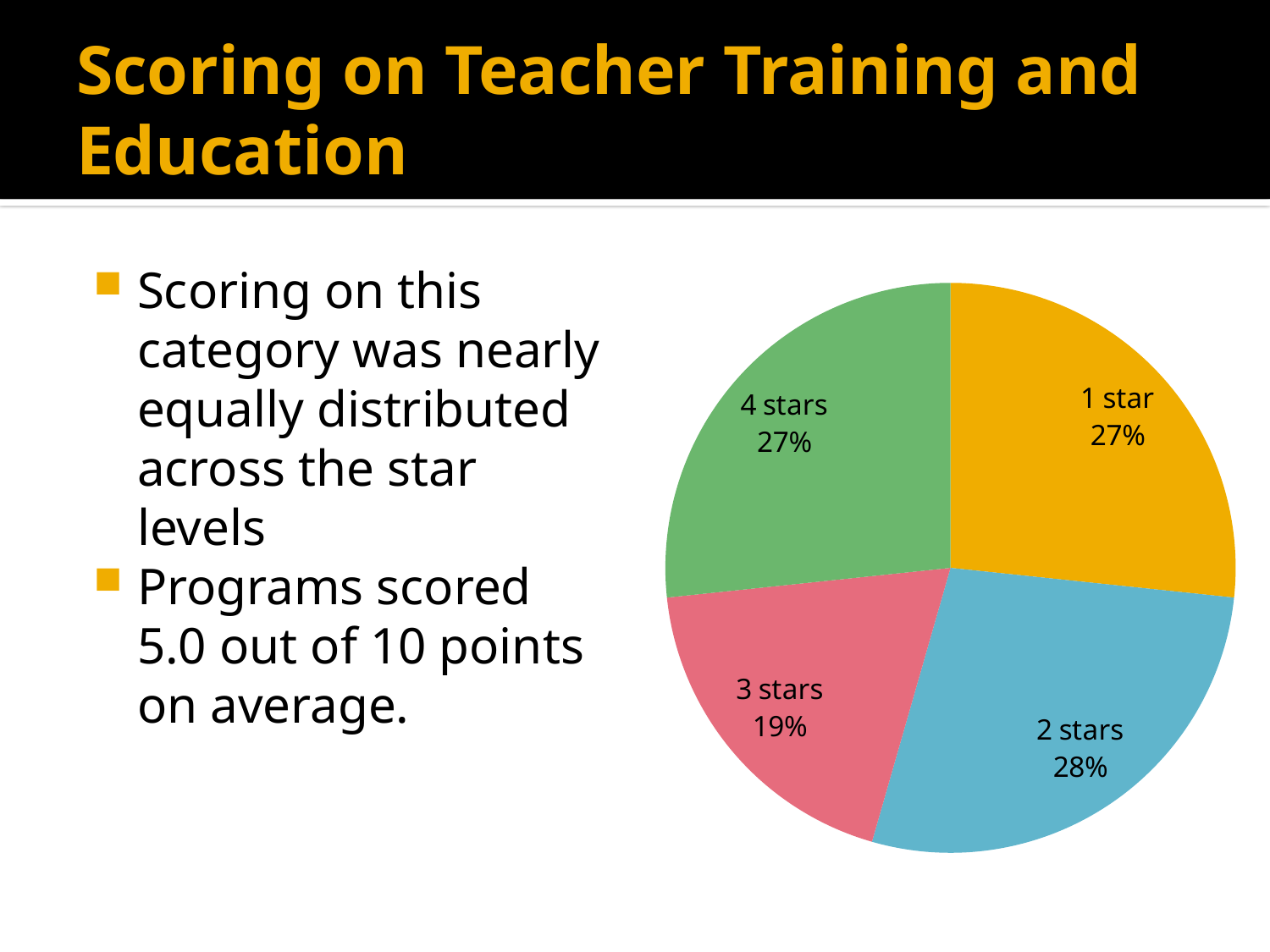
What share of the pie does the 4 stars slice represent? 27% What is the difference in percentage points between the 4 stars slice and the 3 stars slice? 8 How many slices does the pie chart have? 4 What colour is the 3 stars slice of the pie? red Which star level has the largest slice of the pie? 2 stars What kind of chart is shown on the slide? pie chart Which star level has the smallest slice of the pie? 3 stars What share of the pie does the 2 stars slice represent? 28% Which slice is larger, 1 star or 3 stars? 1 star What share of the pie does the 3 stars slice represent? 19% What is the difference in percentage points between the 2 stars slice and the 3 stars slice? 9 What share of the pie does the 1 star slice represent? 27%